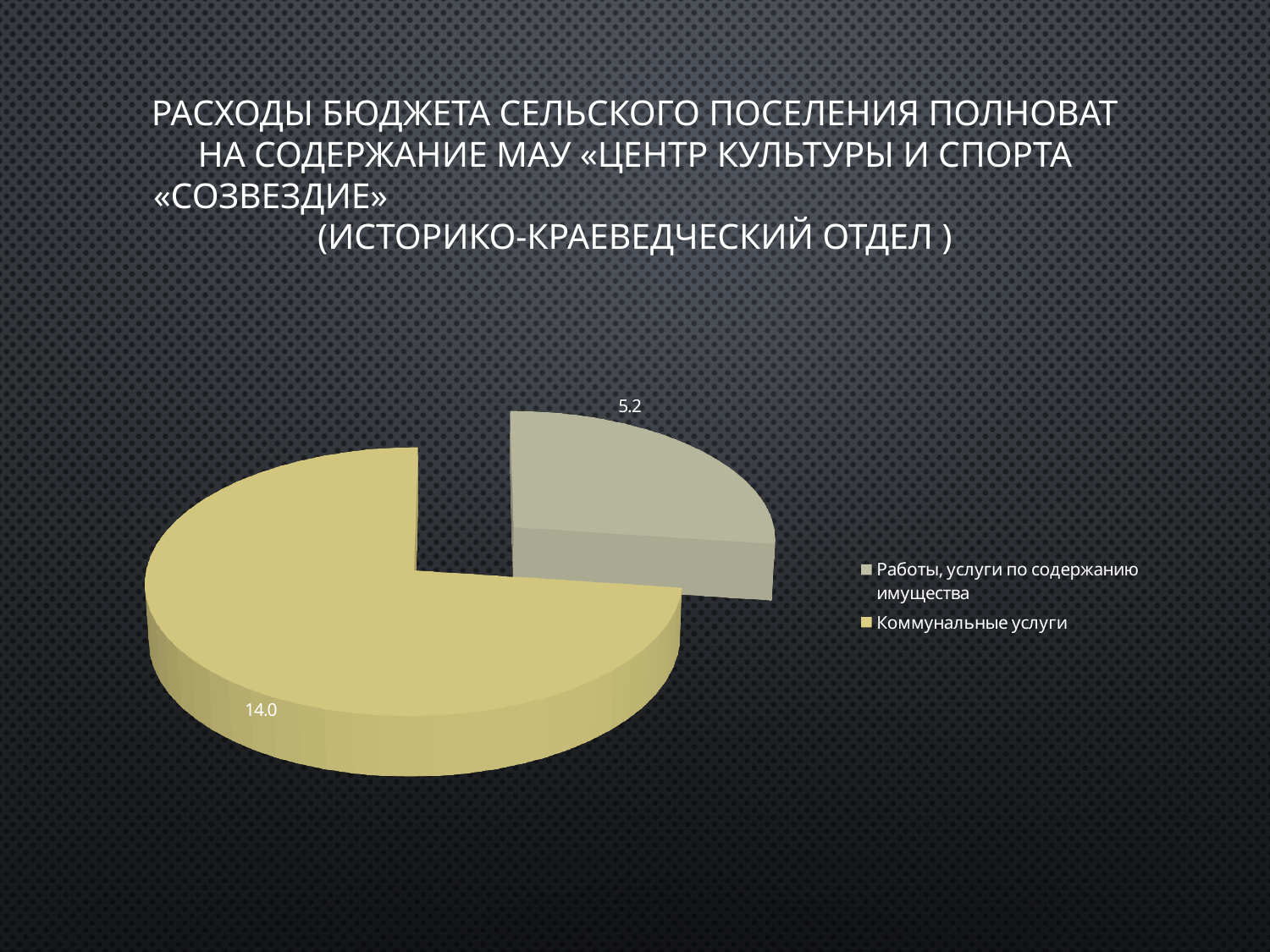
What is the total of all slices in the pie chart? 19.2 What colour is the slice for Коммунальные услуги? yellow What is the value for Коммунальные услуги? 14.0 What is the difference between the values for Коммунальные услуги and Работы, услуги по содержанию имущества? 8.8 Which is larger: Коммунальные услуги or Работы, услуги по содержанию имущества? Коммунальные услуги How many entries does the legend list? 2 How many slices does the pie chart have? 2 What type of chart is shown on the slide? pie chart What is the value for Работы, услуги по содержанию имущества? 5.2 Which category has the largest slice of the pie? Коммунальные услуги Which category has the smallest slice of the pie? Работы, услуги по содержанию имущества